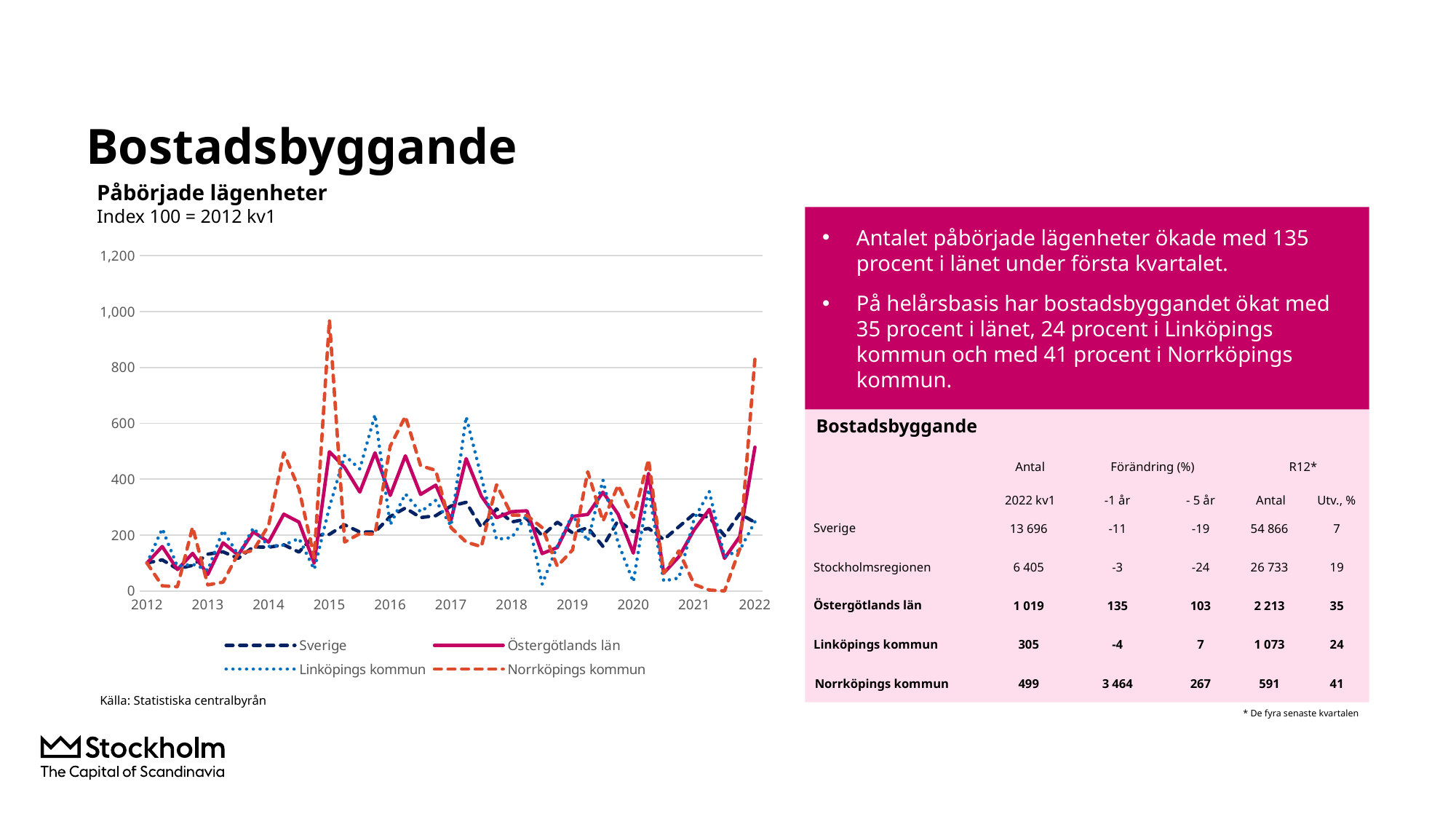
Is the value for Norrköpings kommun at the final point in 2022 greater or less than 600? greater Is the value for Sverige at the end of the chart in 2022 greater or less than 400? less What is the title of the chart? Påbörjade lägenheter What kind of chart is shown on the slide? line chart Does the Östergötlands län line rise or fall between 2021 and the final point in 2022? rise Is the value for Östergötlands län at the final point in 2022 greater or less than 400? greater Which series reaches the highest value anywhere on the chart? Norrköpings kommun Which series has the highest value at the final point in 2022? Norrköpings kommun How many year labels are shown on the x axis? 11 What is the base of the index used in the chart, as stated under the chart title? Index 100 = 2012 kv1 How many series does the chart legend list? 4